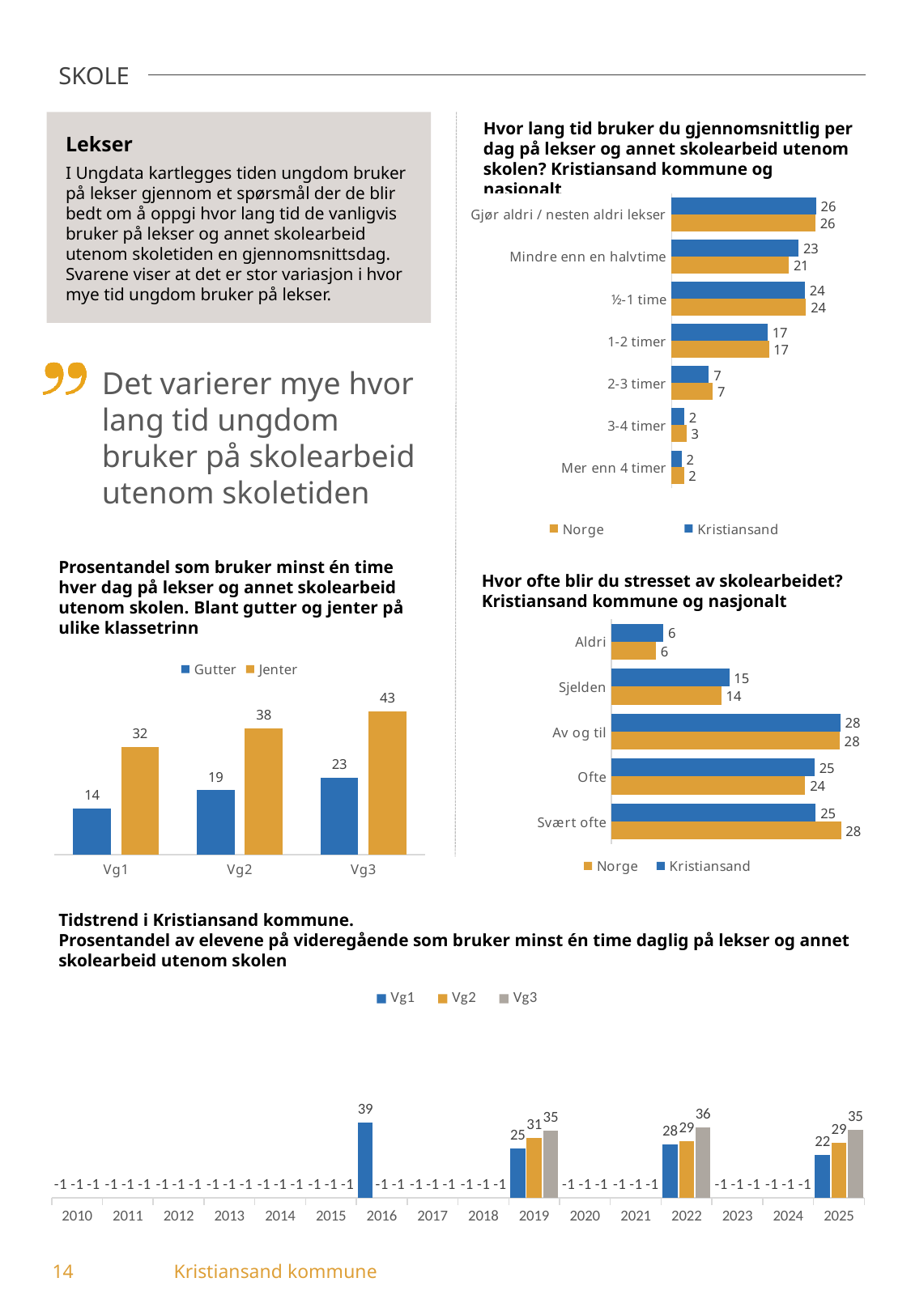
In the chart 'Tidstrend i Kristiansand kommune', what is the Vg1 value in 2016? 39 In the chart 'Hvor ofte blir du stresset av skolearbeidet?', what is the Norge value for 'Svært ofte'? 28 In the chart 'Prosentandel som bruker minst én time hver dag på lekser og annet skolearbeid utenom skolen', do the Gutter values rise or fall from Vg1 to Vg3? rise In the chart 'Hvor lang tid bruker du gjennomsnittlig per dag på lekser og annet skolearbeid utenom skolen?', what is the Kristiansand value for 'Mindre enn en halvtime'? 23 In the chart 'Hvor ofte blir du stresset av skolearbeidet?', which category has the lowest values? Aldri In the chart 'Hvor ofte blir du stresset av skolearbeidet?', which is larger for 'Sjelden': Kristiansand or Norge? Kristiansand In the chart 'Tidstrend i Kristiansand kommune', what is the difference between Vg3 and Vg1 in 2025? 13 In the chart 'Prosentandel som bruker minst én time hver dag på lekser og annet skolearbeid utenom skolen', what is the difference between Jenter and Gutter at Vg1? 18 In the chart 'Hvor lang tid bruker du gjennomsnittlig per dag på lekser og annet skolearbeid utenom skolen?', which category has the highest Kristiansand value? Gjør aldri / nesten aldri lekser In the chart 'Tidstrend i Kristiansand kommune', how many series does the legend list? 3 In the chart 'Hvor lang tid bruker du gjennomsnittlig per dag på lekser og annet skolearbeid utenom skolen?', how many categories are shown? 7 In the chart 'Prosentandel som bruker minst én time hver dag på lekser og annet skolearbeid utenom skolen', what is the value for Jenter at Vg3? 43